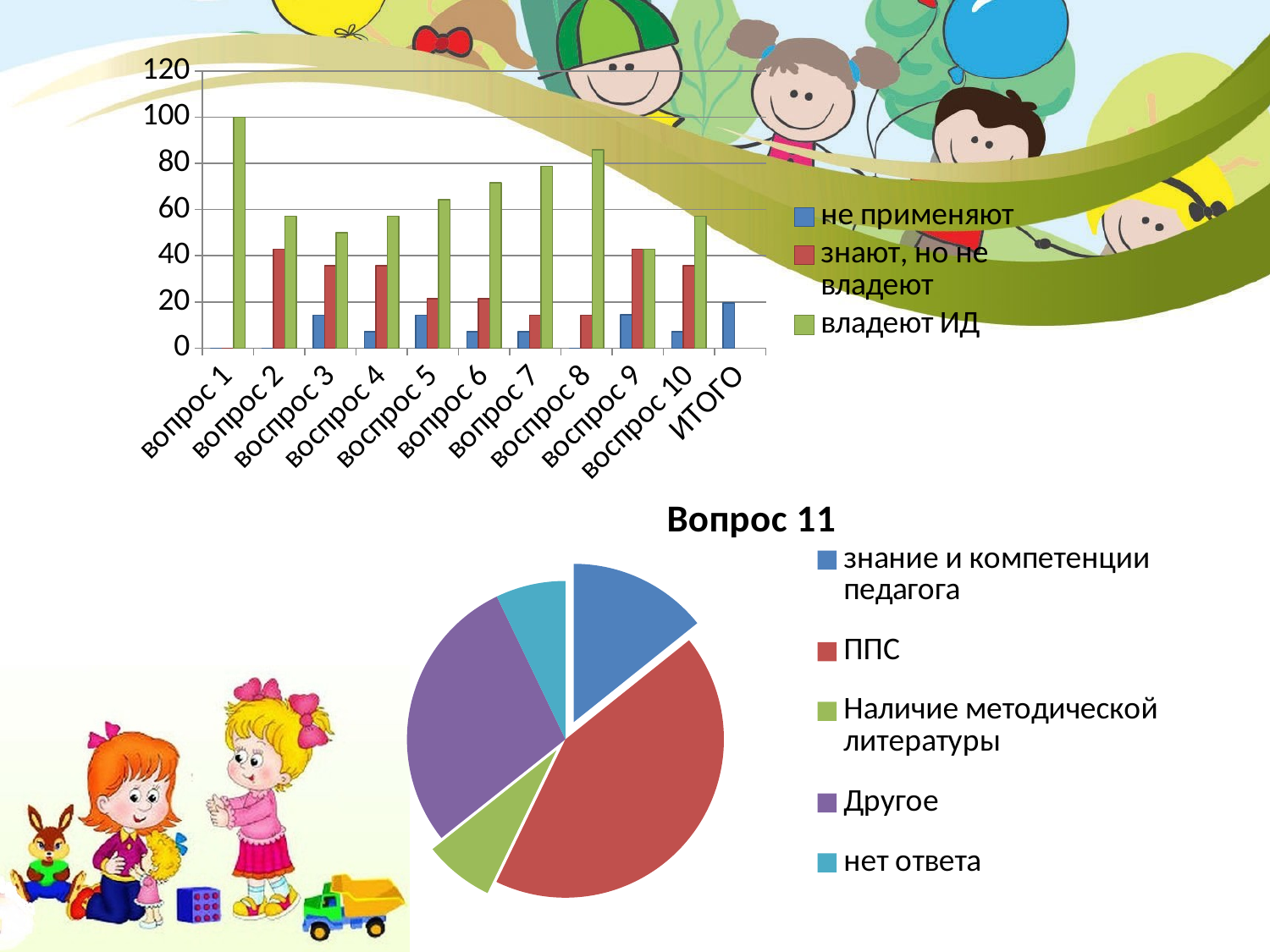
What kind of chart is the chart titled "Вопрос 11"? pie chart In the top bar chart, what is the value of "владеют ИД" for вопрос 1? 100 In the top bar chart, how many categories are shown on the x axis? 11 What kind of chart is the top chart on the slide? bar chart In the pie chart "Вопрос 11", which category has the largest slice? ППС In the top bar chart, is the value of "владеют ИД" for вопрос 8 greater or less than 80? greater In the top bar chart, for вопрос 2, which is larger: "знают, но не владеют" or "владеют ИД"? владеют ИД In the pie chart "Вопрос 11", how many entries does the legend list? 5 In the top bar chart, which category has the highest value for "владеют ИД"? вопрос 1 In the top bar chart, how many series does the legend list? 3 In the top bar chart, is the value of "не применяют" for вопрос 3 greater or less than 20? less In the top bar chart, what colour represents the series "владеют ИД"? green